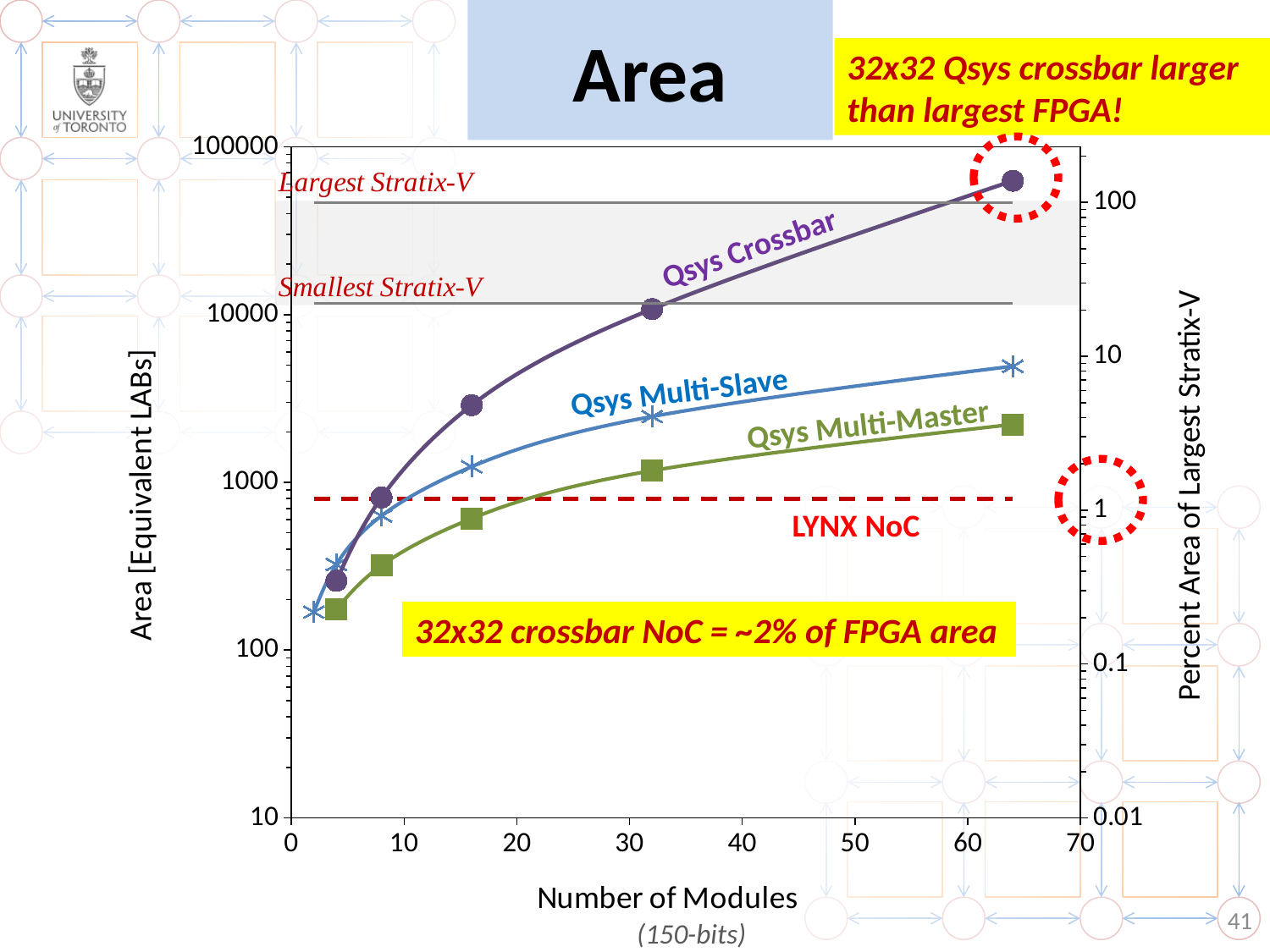
Which series has the lowest area at 64 modules? Qsys Multi-Master Does the Qsys Crossbar area rise or fall as the number of modules increases? rise Which series has the highest area at 64 modules? Qsys Crossbar Is the Qsys Multi-Master area at 8 modules greater or less than 1000 equivalent LABs? less Is the LYNX NoC dashed line greater or less than 1000 equivalent LABs? less What is the title of the slide's chart? Area At 32 modules, which has the larger area: Qsys Crossbar or Qsys Multi-Slave? Qsys Crossbar Is the Qsys Crossbar area at 64 modules greater or less than 10000 equivalent LABs? greater What kind of chart is shown on the slide? line chart How many Qsys series are plotted on the chart? 3 What is the label of the x axis? Number of Modules